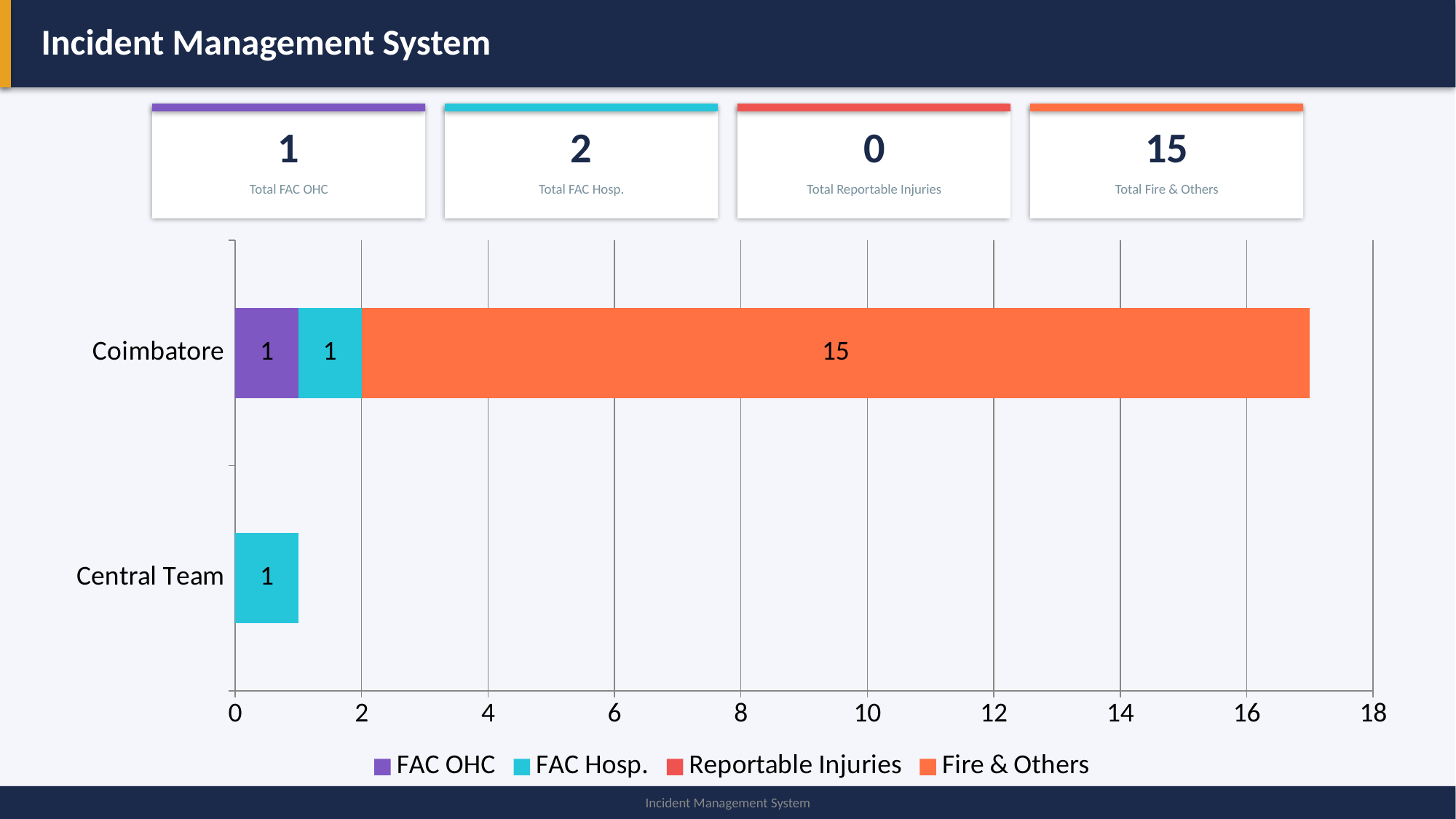
What is the FAC OHC value for Coimbatore? 1 What kind of chart is shown on the slide? Stacked bar chart Which category has the longer stacked bar, Coimbatore or Central Team? Coimbatore What is the FAC Hosp. value for Central Team? 1 What is the difference between the Fire & Others value for Coimbatore and the FAC Hosp. value for Central Team? 14 What is the maximum value shown on the x axis? 18 What is the Fire & Others value for Coimbatore? 15 What is the total of the stacked bar for Coimbatore? 17 Is the total stacked bar for Coimbatore greater or less than 16? greater Which series is shown in orange in the legend? Fire & Others How many series does the legend list? 4 How many categories are shown on the chart? 2